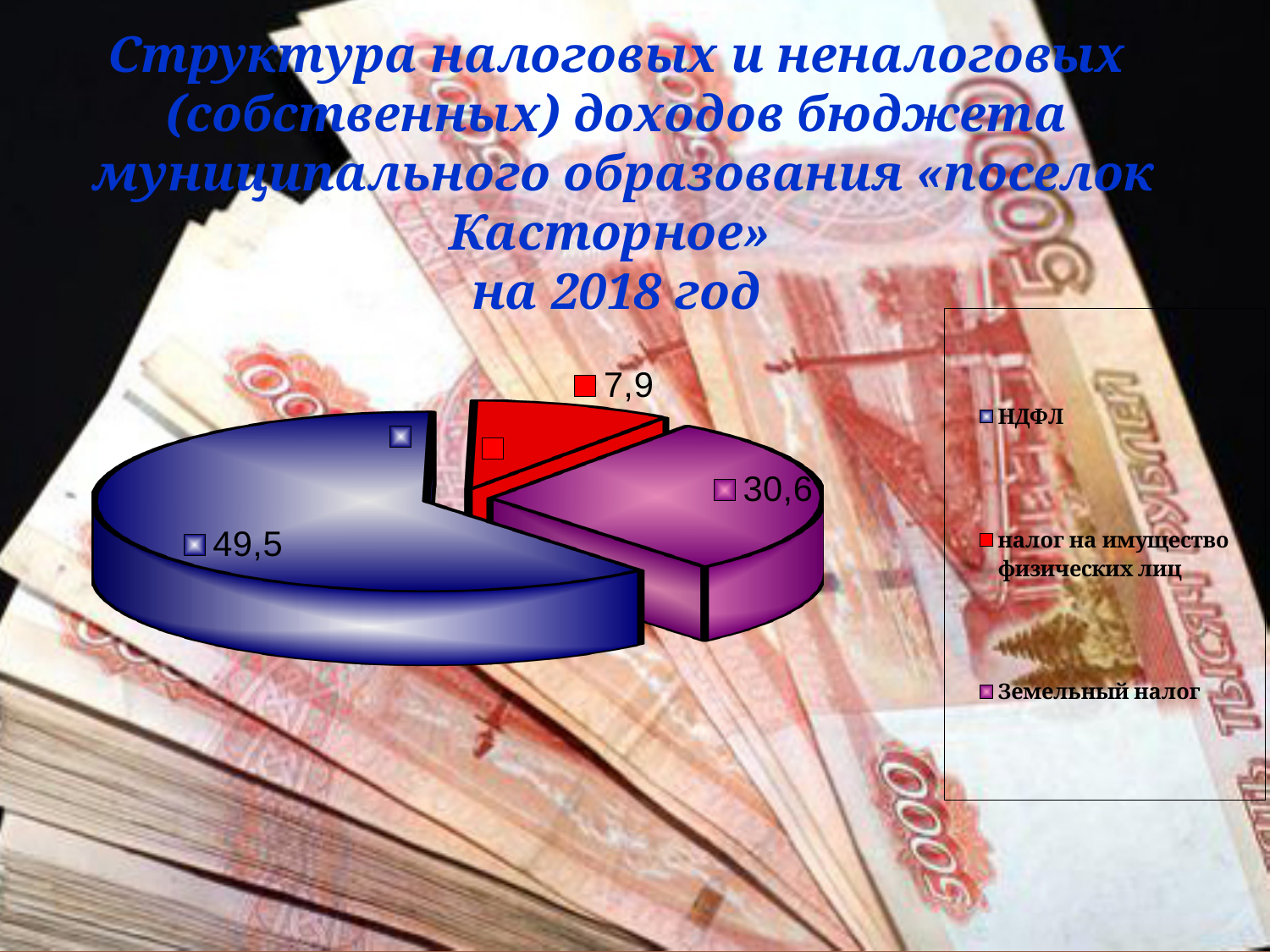
What is the difference between the values for Земельный налог and налог на имущество физических лиц? 22,7 How many slices does the pie chart have? 3 What is the difference between the values for НДФЛ and Земельный налог? 18,9 What is the value shown for НДФЛ? 49,5 What kind of chart is shown on the slide? Pie chart Which category has the smallest slice of the pie? налог на имущество физических лиц How many entries does the legend list? 3 What is the value shown for Земельный налог? 30,6 Which category has the largest slice of the pie? НДФЛ What is the value shown for налог на имущество физических лиц? 7,9 Which is larger, the value for Земельный налог or the value for налог на имущество физических лиц? Земельный налог What colour is the slice for налог на имущество физических лиц? Red